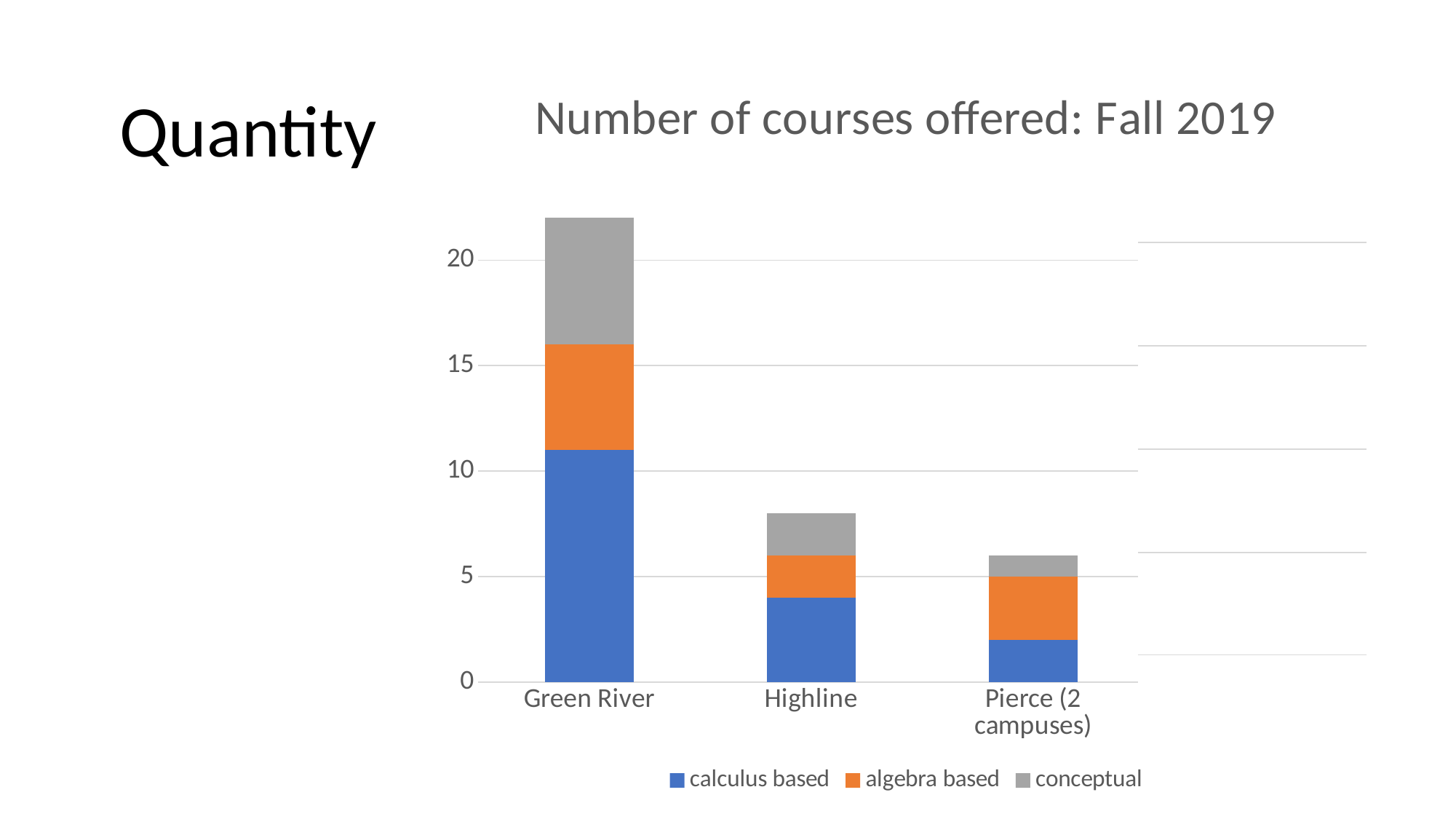
Which college has the highest total number of courses offered? Green River What kind of chart is shown on the slide? stacked bar chart Is the total number of courses for Green River greater or less than 20? greater Is the total number of courses for Highline greater or less than 10? less Is the total number of courses for Pierce (2 campuses) greater or less than 10? less Which college has the lowest total number of courses offered? Pierce (2 campuses) What is the title of the chart? Number of courses offered: Fall 2019 How many colleges (categories) are shown on the x axis? 3 Which series is shown in orange in the legend? algebra based How many series does the legend list? 3 Which college offers more calculus based courses, Green River or Highline? Green River